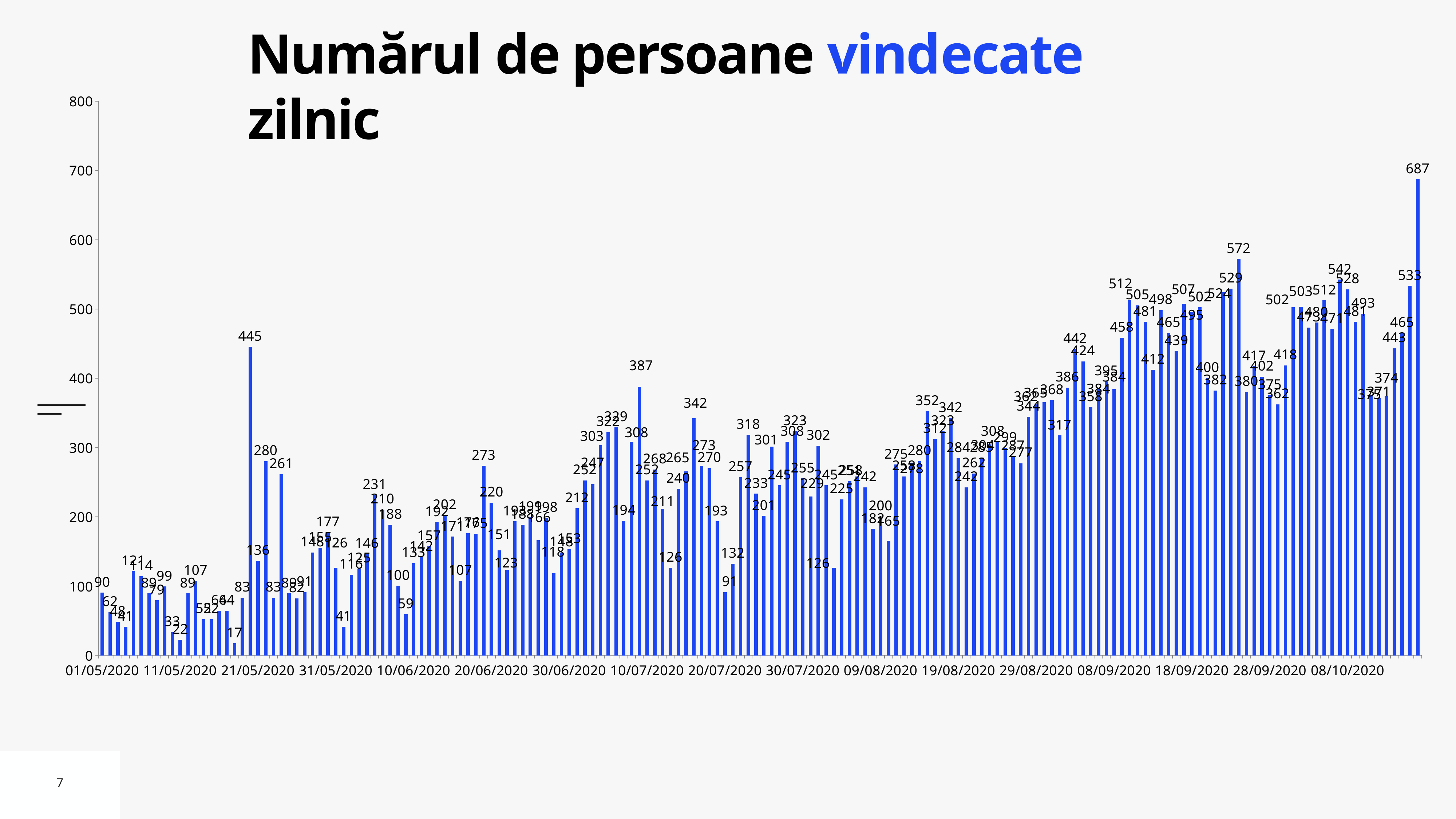
Which is larger, the value for 01/05/2020 or the value of the last bar? the last bar What is the value of the tallest bar between 30/06/2020 and 20/07/2020? 387 What kind of chart is shown on the slide? bar chart Is the highest value in the chart greater or less than 600? greater What is the value of the tallest bar before 10/06/2020? 445 What is the value of the first bar, for 01/05/2020? 90 What is the difference between the highest and the lowest value in the chart? 670 What is the value of the last bar in the chart? 687 What is the highest value shown in the chart? 687 What is the title of the chart? Numărul de persoane vindecate zilnic What is the lowest value shown in the chart? 17 Do the values generally rise or fall from May to October 2020? rise